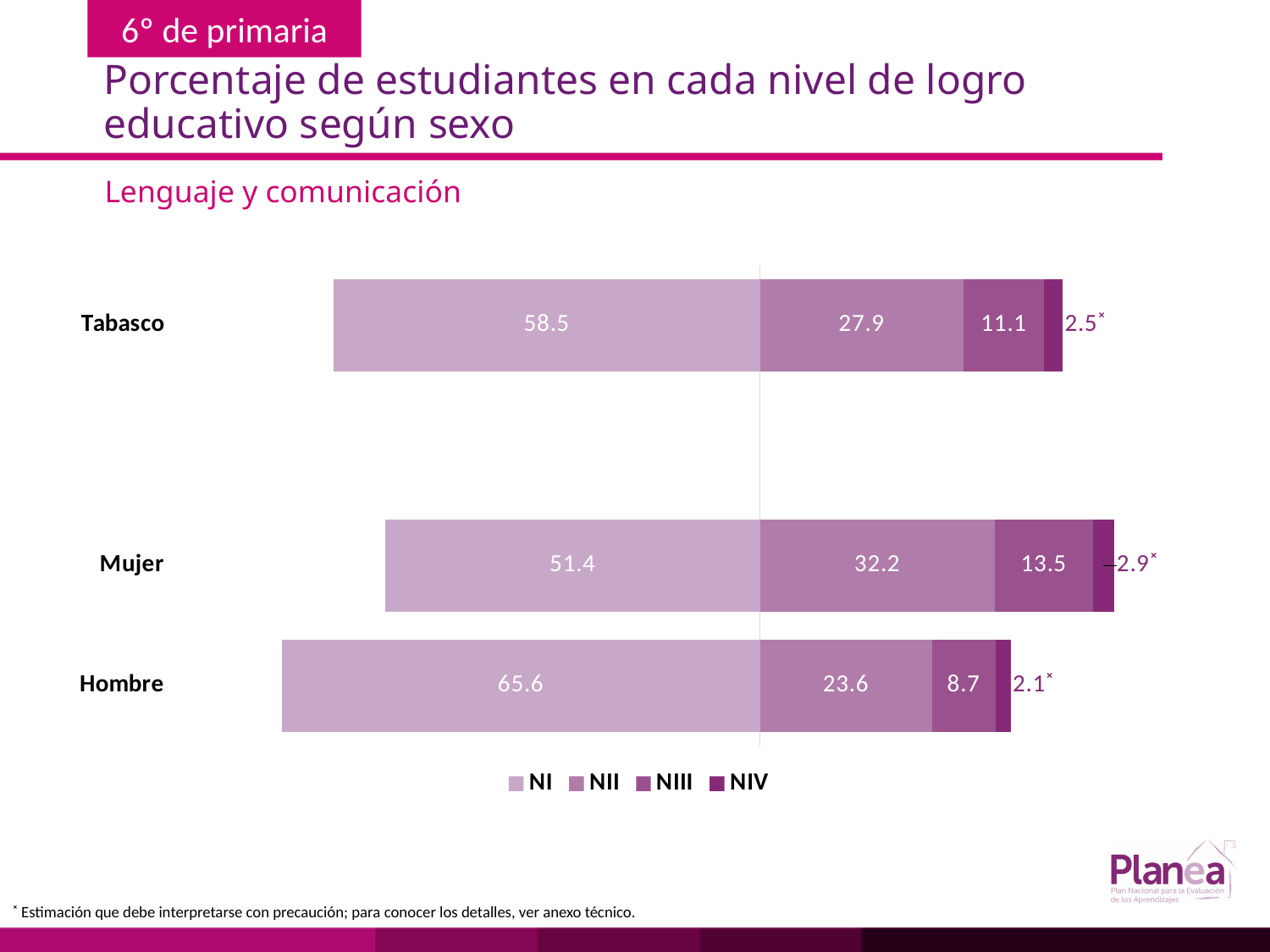
What is the NIV value for Mujer? 2.9 What is the difference between the NI values for Hombre and Mujer? 14.2 What is the NI value for Tabasco? 58.5 What kind of chart is shown on the slide? Stacked bar chart How many categories are shown on the chart? 3 Which is larger, the NII value for Tabasco or the NII value for Hombre? Tabasco How many series does the legend list? 4 Which category has the highest NI value? Hombre What is the total of the stacked bar for Tabasco? 100.0 What is the NII value for Mujer? 32.2 What is the NIII value for Hombre? 8.7 Which category has the lowest NIII value? Hombre